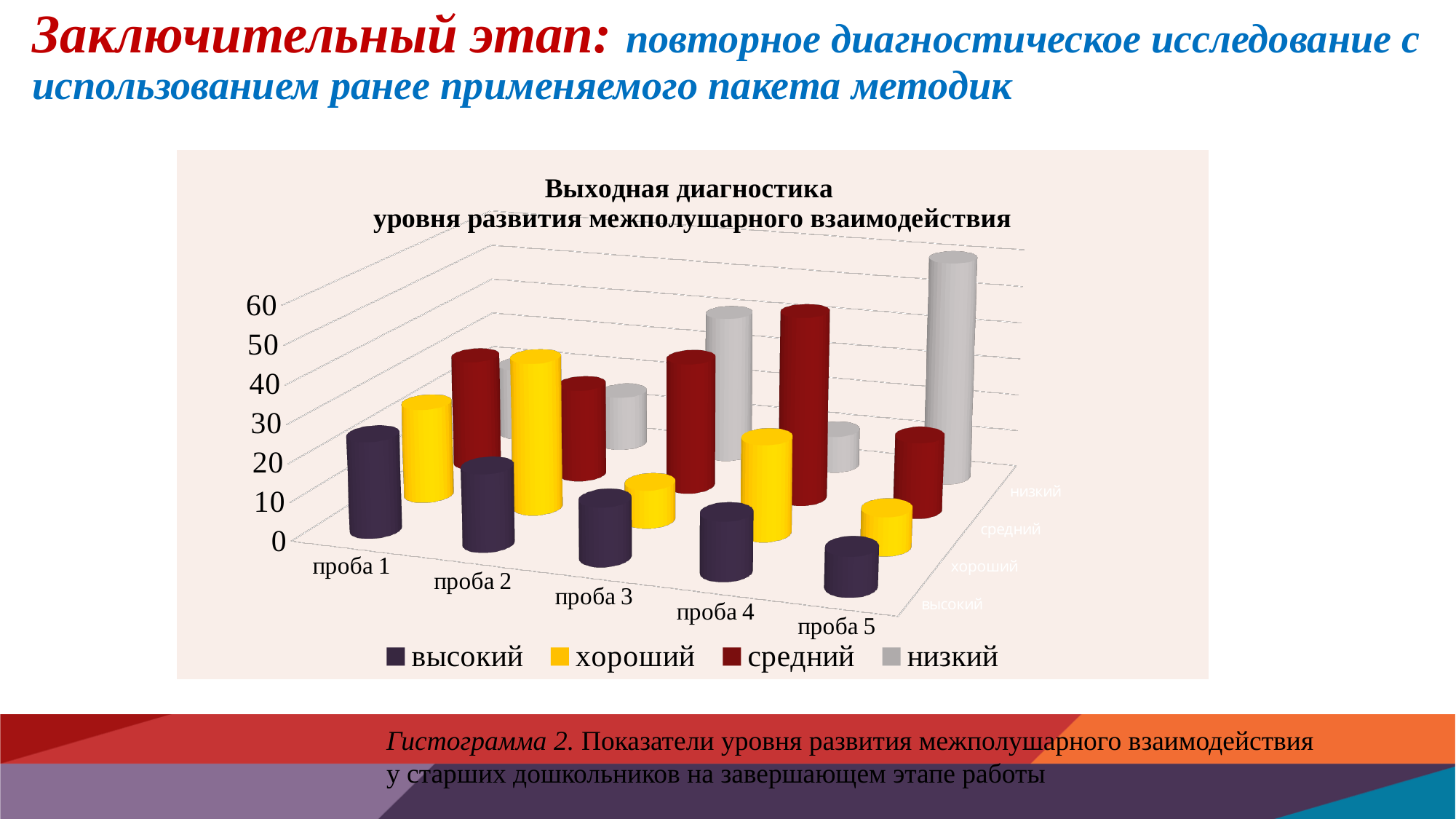
Which series has the tallest bar for проба 5? низкий What are the four series listed in the chart legend? высокий, хороший, средний, низкий Is the высокий value for проба 1 greater or less than 40? less What is the title of the chart? Выходная диагностика уровня развития межполушарного взаимодействия What kind of chart is shown on the slide? bar chart Do the values of the высокий series rise or fall from проба 1 to проба 5? fall Which category has the lowest value in the высокий series? проба 5 For проба 1, which is larger: the высокий value or the средний value? средний How many categories (пробы) are shown on the x axis of the chart? 5 How many series does the chart legend list? 4 Which category has the highest value in the низкий series? проба 5 Which category has the highest value in the высокий series? проба 1